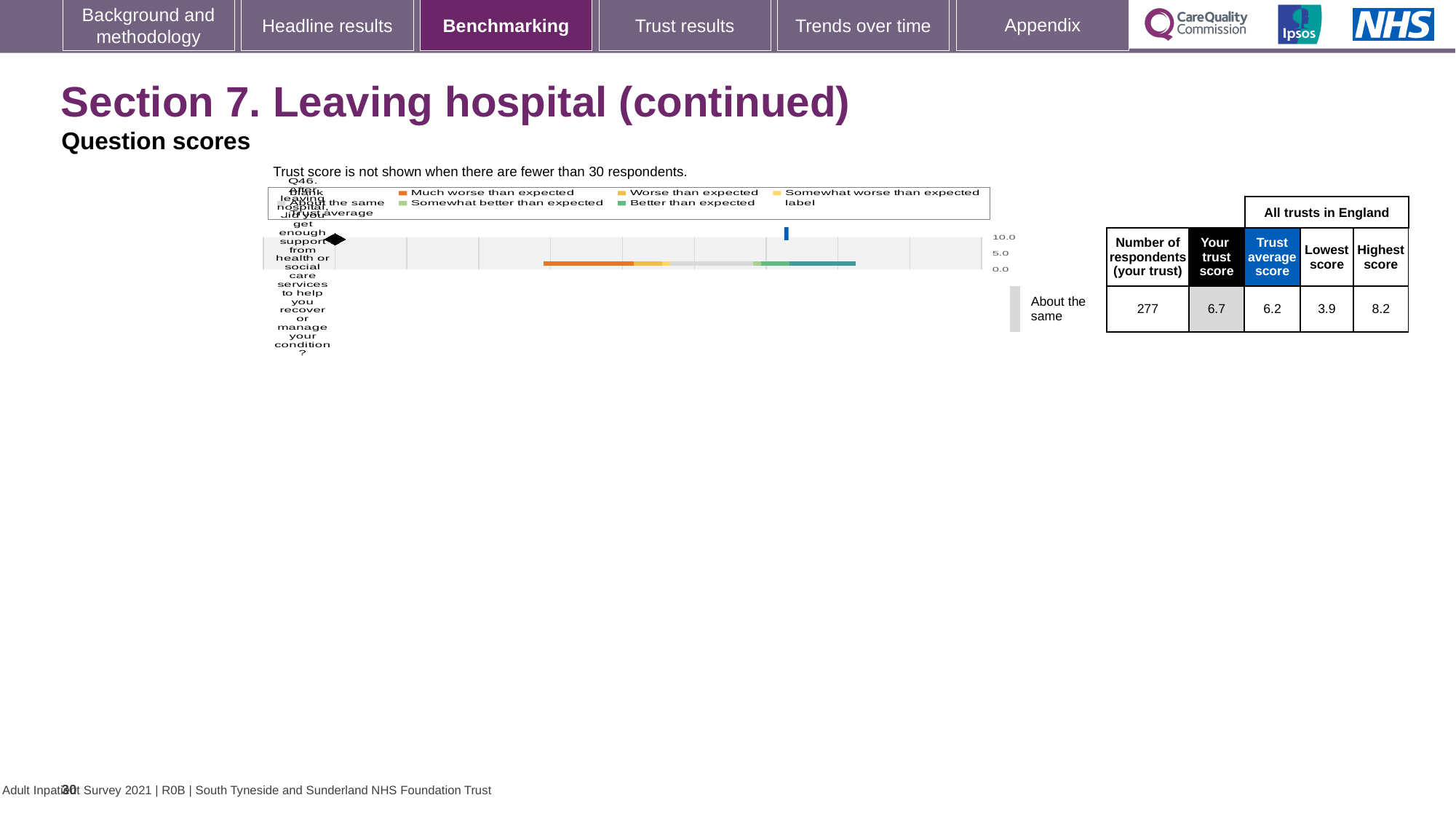
How many respondents from the trust answered Q46? 277 What is the trust's score for Q46 as printed on the slide? 6.7 Which is larger for Q46: the trust's score or the trust average score? the trust's score Which legend entry is shown in orange in the benchmarking chart? Much worse than expected Is the trust's score for Q46 greater or less than 5.0 on the chart axis? greater What is the trust average score for Q46 across all trusts in England? 6.2 How many questions are plotted in the benchmarking chart? 1 What is the lowest score for Q46 among all trusts in England? 3.9 What kind of chart is used to show the Q46 benchmarking result? bar chart What is the highest score for Q46 among all trusts in England? 8.2 What benchmark category is the trust's Q46 result assigned to? About the same What is the difference between the highest score and the lowest score for Q46? 4.3